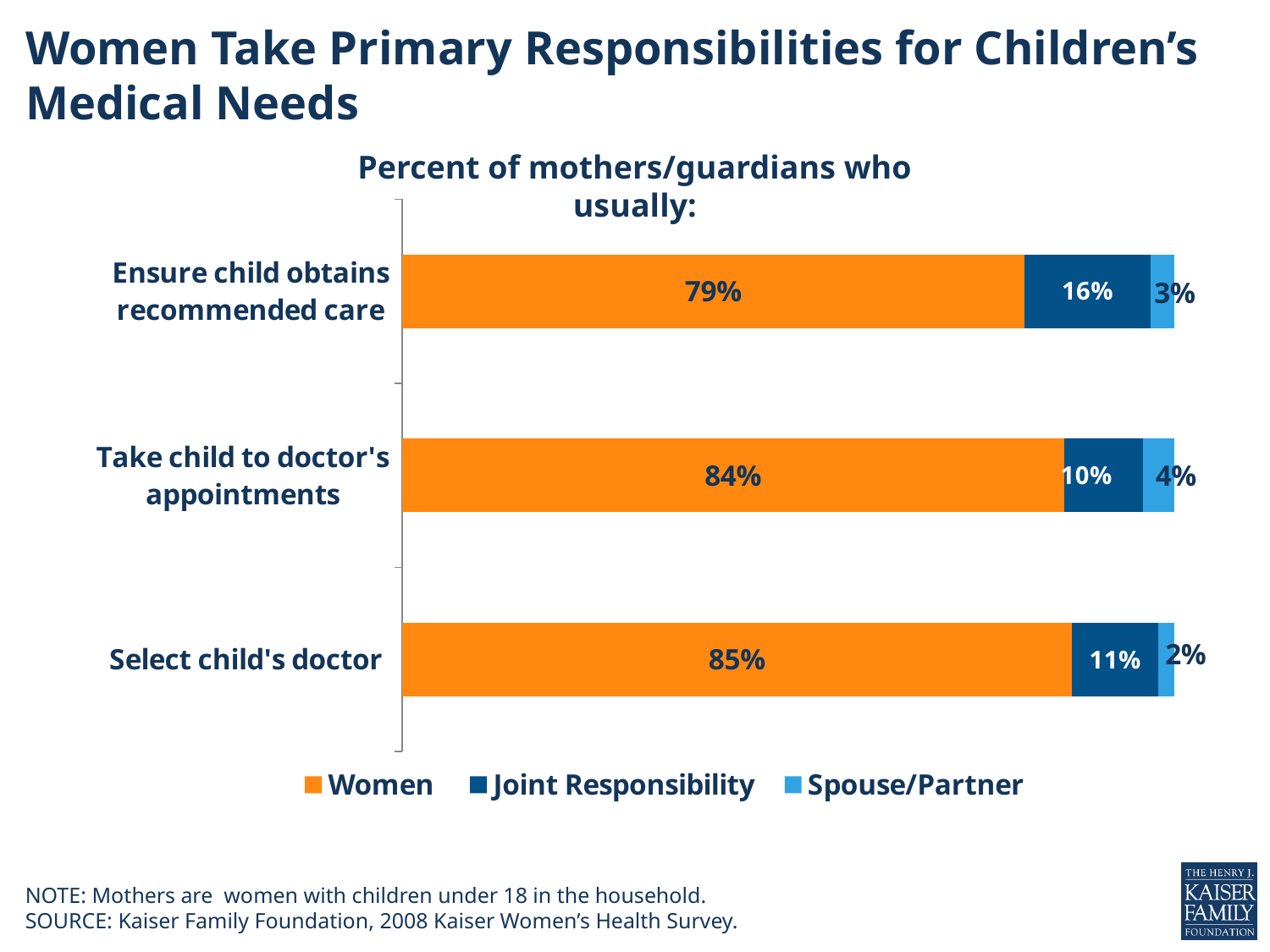
What is the total of the stacked bar for 'Take child to doctor's appointments'? 98% How many categories are shown on the chart? 3 What percent of mothers/guardians say women usually ensure the child obtains recommended care? 79% What kind of chart is shown on the slide? Stacked bar chart For which category is the Women value highest? Select child's doctor Which is larger: the Joint Responsibility value for 'Ensure child obtains recommended care' or for 'Select child's doctor'? Ensure child obtains recommended care For which category is the Joint Responsibility value lowest? Take child to doctor's appointments What is the Joint Responsibility value for 'Take child to doctor's appointments'? 10% What is the difference between the Women values for 'Select child's doctor' and 'Ensure child obtains recommended care'? 6% What is the Spouse/Partner value for 'Select child's doctor'? 2% How many series does the legend list? 3 Which series is shown in orange in the legend? Women